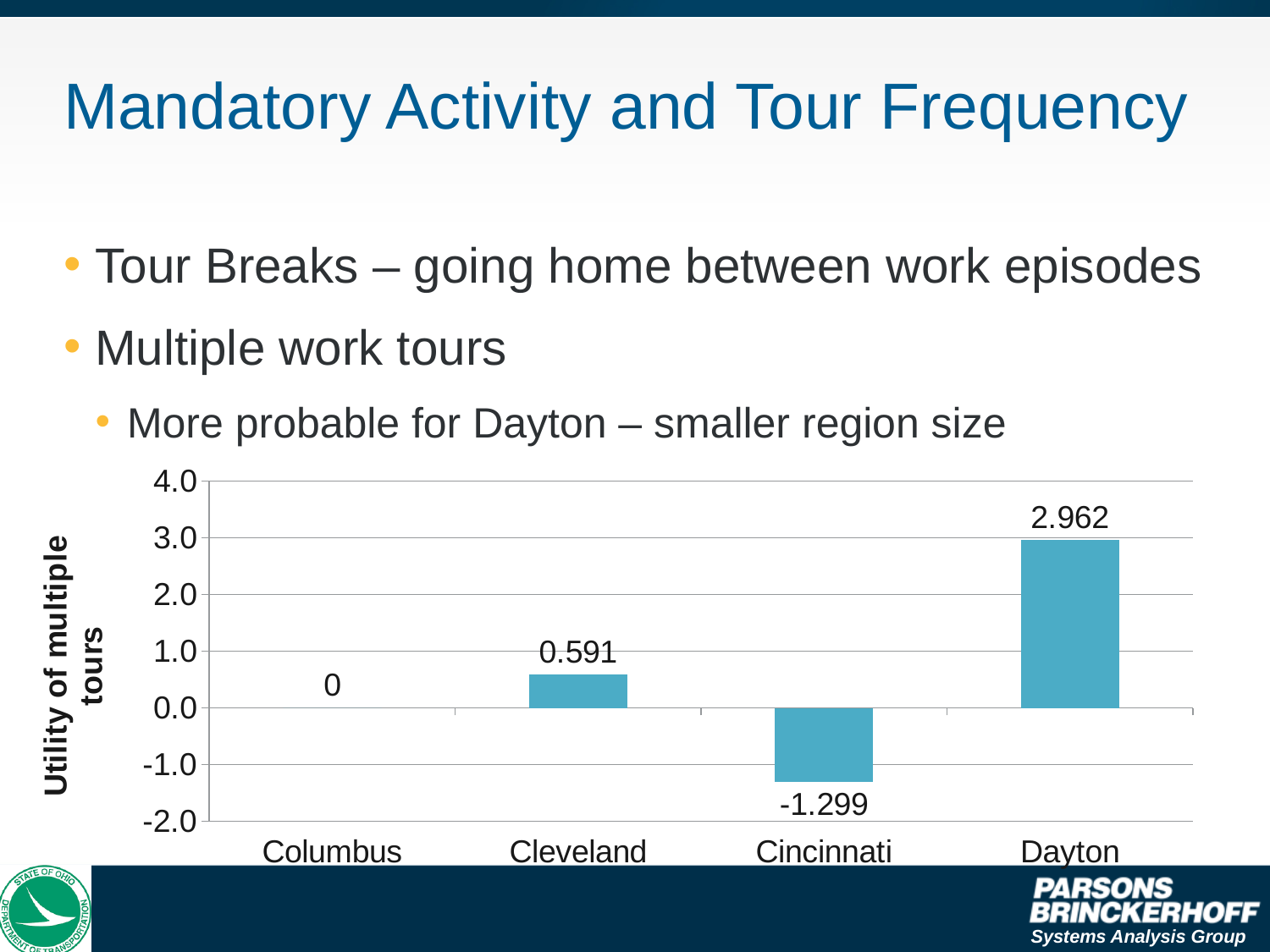
What is the utility of multiple tours for Columbus? 0 Is the value for Dayton greater or less than 2.0? greater What is the utility of multiple tours for Dayton? 2.962 What is the utility of multiple tours for Cleveland? 0.591 What is the utility of multiple tours for Cincinnati? -1.299 What is the label of the vertical axis of the chart? Utility of multiple tours What kind of chart is shown on the slide? bar chart What is the difference between the utility values for Dayton and Cleveland? 2.371 Which has a larger utility of multiple tours, Cleveland or Cincinnati? Cleveland Which region has the lowest utility of multiple tours? Cincinnati Which region has the highest utility of multiple tours? Dayton How many regions are shown on the x axis of the chart? 4